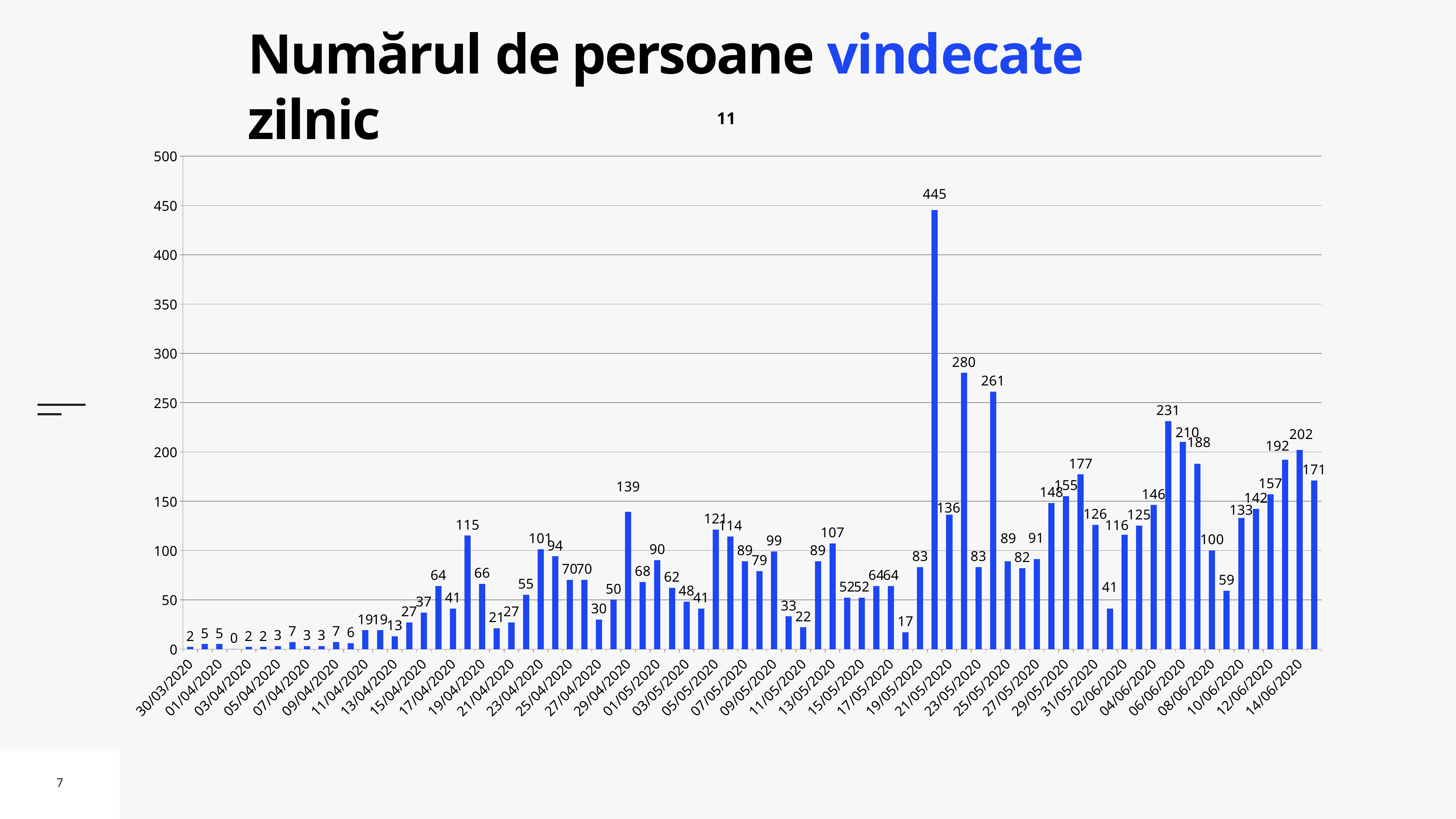
What is the value for 13/05/2020? 107 What is the value for 06/06/2020? 210 What is the value for 29/04/2020? 139 What kind of chart is shown on the slide? bar chart Which is larger, the value for 23/04/2020 or the value for 01/05/2020? 23/04/2020 What is the value for 14/06/2020? 202 What is the lowest value shown on the chart? 0 What is the difference between the values for 14/06/2020 and 12/06/2020? 45 Overall, do the values rise or fall from the start of the x axis to the end? rise Is the value for 29/05/2020 greater or less than 150? greater What is the highest value shown on the chart? 445 What is the title of the slide? Numărul de persoane vindecate zilnic